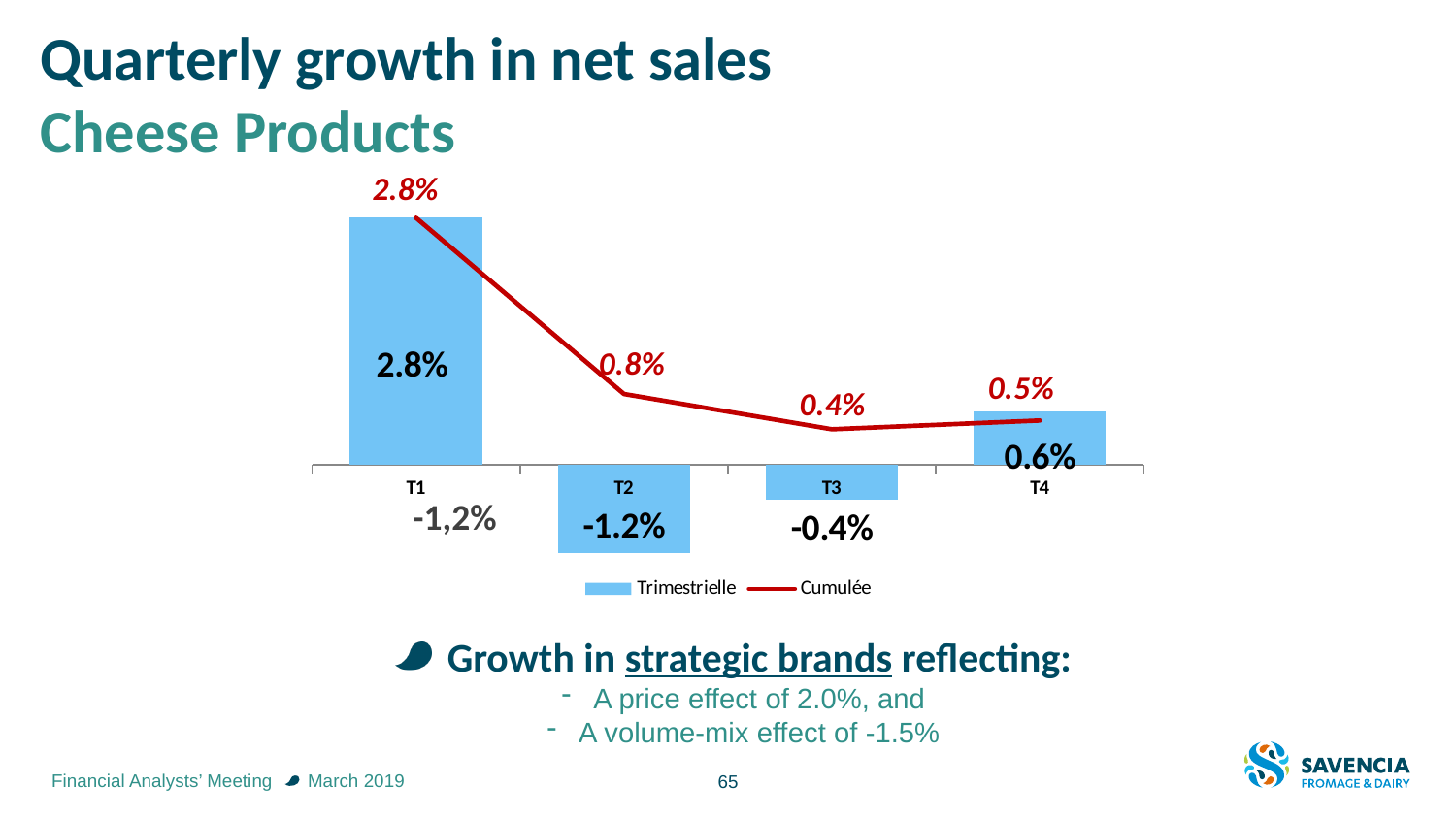
What is the Cumulée (cumulative) value at T2? 0.8% What is the Cumulée (cumulative) value at T3? 0.4% What is the difference between the Cumulée values at T1 and T2? 2.0% How many series does the legend list? 2 What kind of chart is used to show the Trimestrielle series? Bar chart What is the Trimestrielle (quarterly) value for T2? -1.2% Which is larger, the Trimestrielle value for T3 or for T4? T4 Which quarter has the highest Trimestrielle (quarterly) value? T1 How many quarters are shown on the x axis? 4 What is the Trimestrielle (quarterly) value for T4? 0.6% Which quarter has the lowest Trimestrielle (quarterly) value? T2 What is the Trimestrielle (quarterly) value for T1? 2.8%